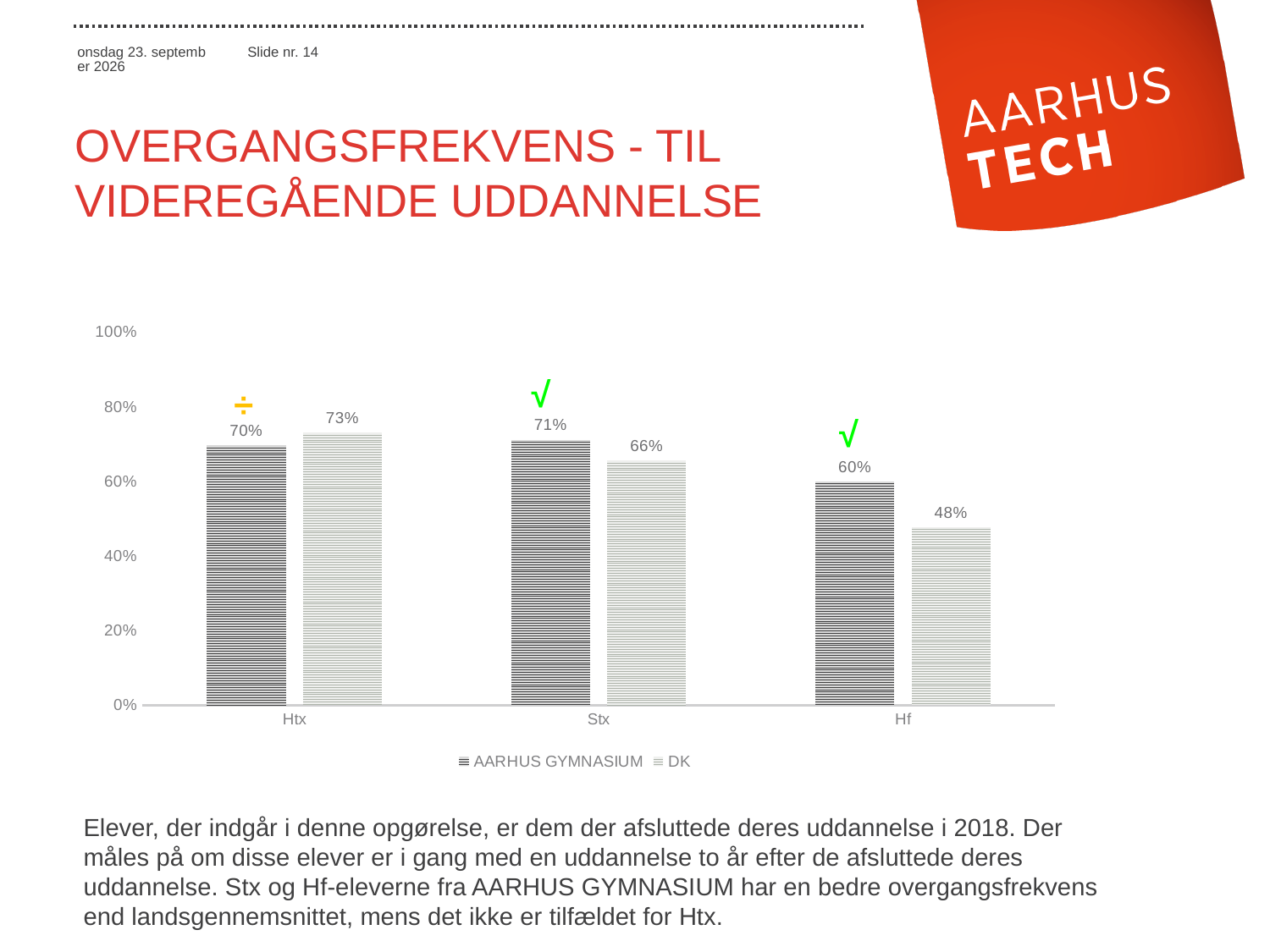
What kind of chart is shown on the slide? Bar chart Which is larger in the Stx category, AARHUS GYMNASIUM or DK? AARHUS GYMNASIUM What is the value for DK in the Hf category? 48% What is the value for AARHUS GYMNASIUM in the Htx category? 70% What is the difference between AARHUS GYMNASIUM and DK in the Hf category? 12% How many series does the legend list? 2 Which is larger in the Htx category, AARHUS GYMNASIUM or DK? DK What is the value for DK in the Stx category? 66% How many categories are shown on the x axis? 3 Which category has the highest value for the DK series? Htx What is the difference between the DK values for Htx and Hf? 25% Which category has the lowest value for the AARHUS GYMNASIUM series? Hf